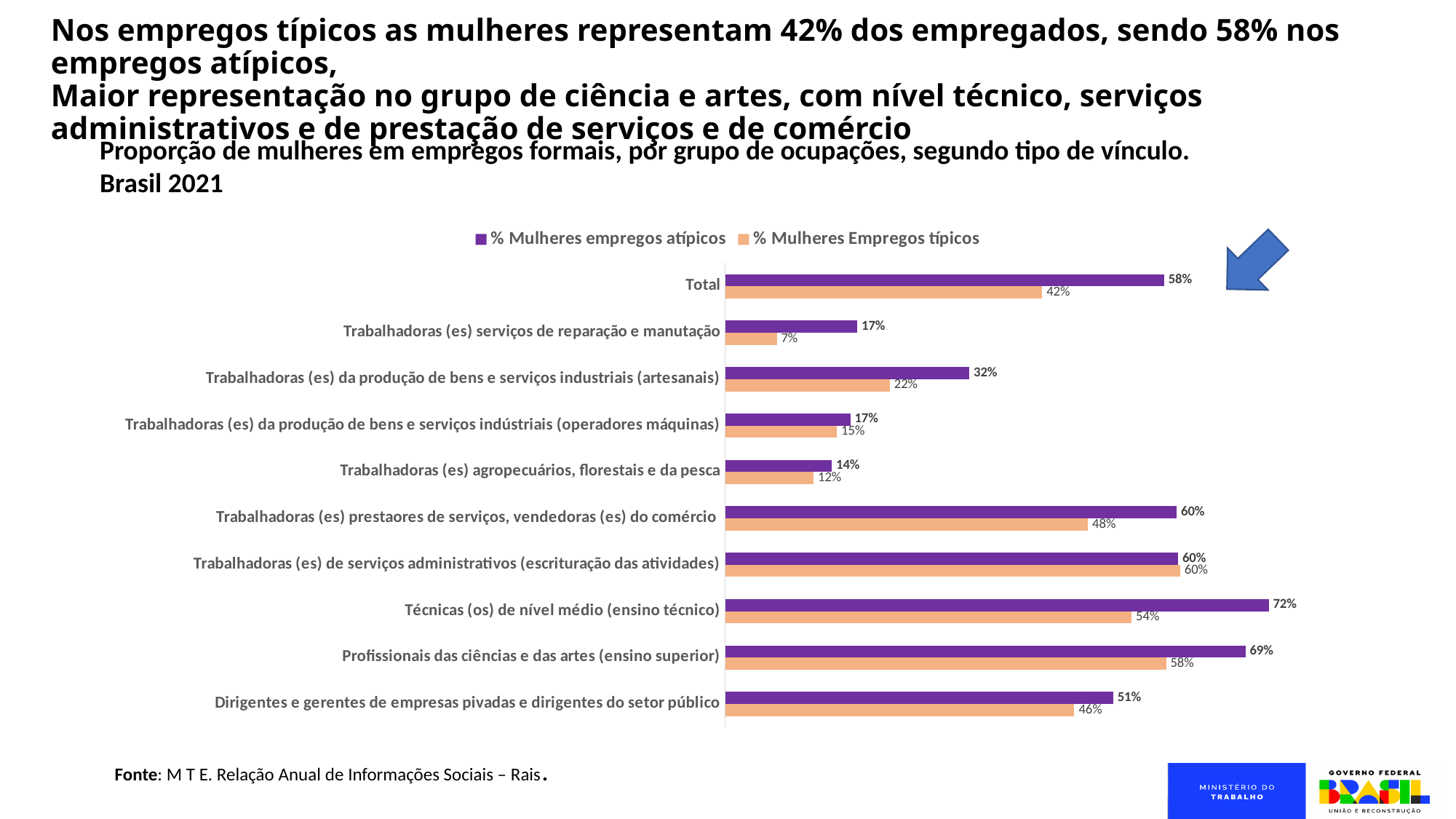
Which category has the lowest value for % Mulheres Empregos típicos? Trabalhadoras (es) serviços de reparação e manutação What is the value of % Mulheres Empregos típicos for Trabalhadoras (es) serviços de reparação e manutação? 7% How many series does the legend list? 2 What is the value of % Mulheres empregos atípicos for Total? 58% How many categories are plotted on the chart, including Total? 10 Which category has the highest value for % Mulheres empregos atípicos? Técnicas (os) de nível médio (ensino técnico) Which is larger for Dirigentes e gerentes de empresas pivadas e dirigentes do setor público: % Mulheres empregos atípicos or % Mulheres Empregos típicos? % Mulheres empregos atípicos What colour are the bars for % Mulheres empregos atípicos? Purple What is the value of % Mulheres Empregos típicos for Técnicas (os) de nível médio (ensino técnico)? 54% What is the difference between % Mulheres empregos atípicos and % Mulheres Empregos típicos for Profissionais das ciências e das artes (ensino superior)? 11% What is the difference between % Mulheres empregos atípicos and % Mulheres Empregos típicos for Total? 16% What kind of chart is shown on the slide? Bar chart